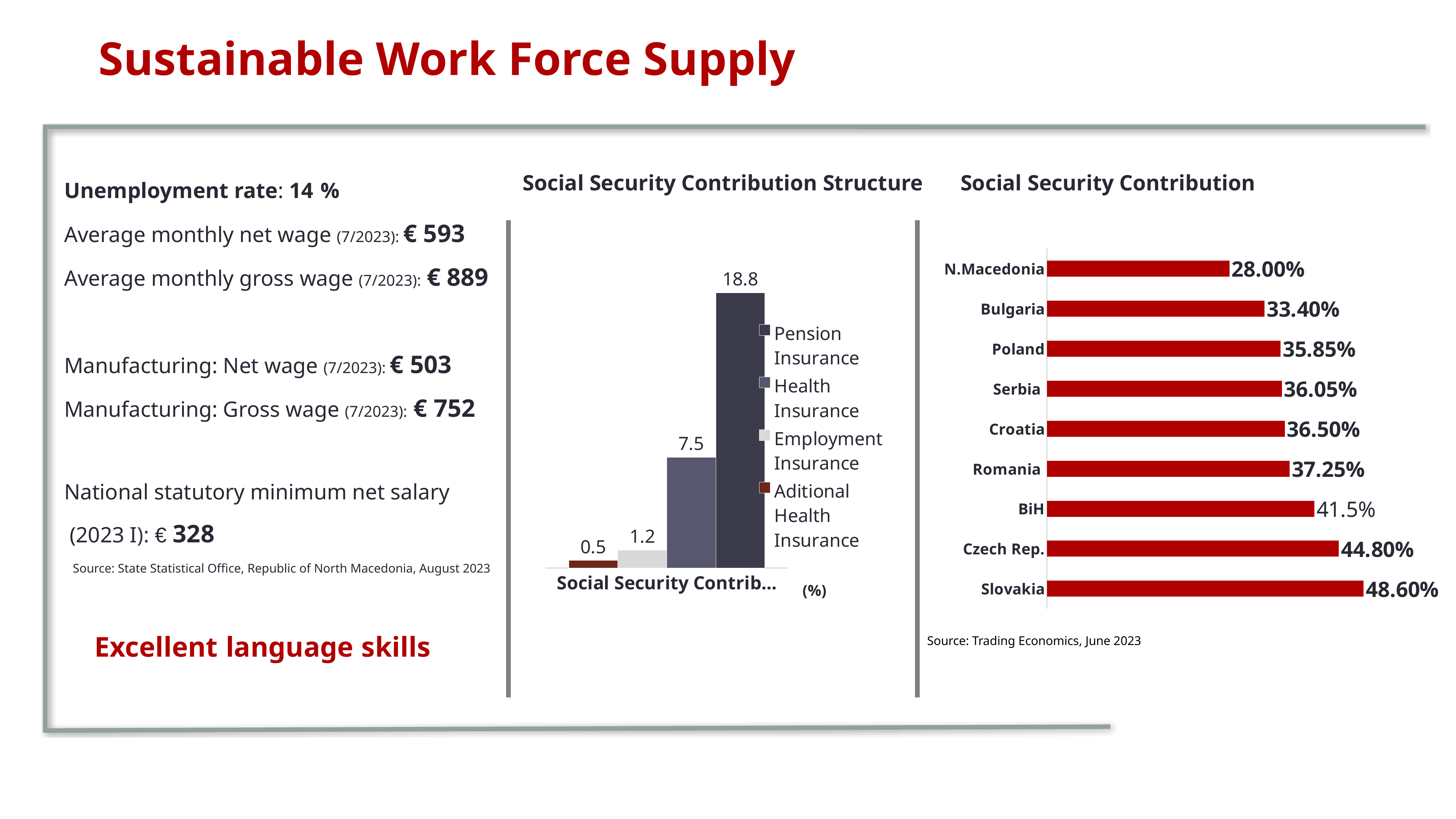
In the 'Social Security Contribution' chart, which is larger, the value for Czech Rep. or the value for BiH? Czech Rep. In the 'Social Security Contribution Structure' chart, what is the value for Pension Insurance? 18.8 In the 'Social Security Contribution' chart, which country has the lowest value? N.Macedonia In the 'Social Security Contribution' chart, which country has the highest value? Slovakia In the 'Social Security Contribution' chart, how many countries are shown? 9 In the 'Social Security Contribution' chart, what is the value for N.Macedonia? 28.00% In the 'Social Security Contribution' chart, what is the value for Slovakia? 48.60% What kind of chart is the 'Social Security Contribution' chart? Bar chart In the 'Social Security Contribution' chart, what is the difference between the values for Bulgaria and N.Macedonia? 5.40% In the 'Social Security Contribution Structure' chart, what is the value for Employment Insurance? 1.2 In the 'Social Security Contribution Structure' chart, which series has the lowest value? Aditional Health Insurance In the 'Social Security Contribution Structure' chart, how many series does the legend list? 4